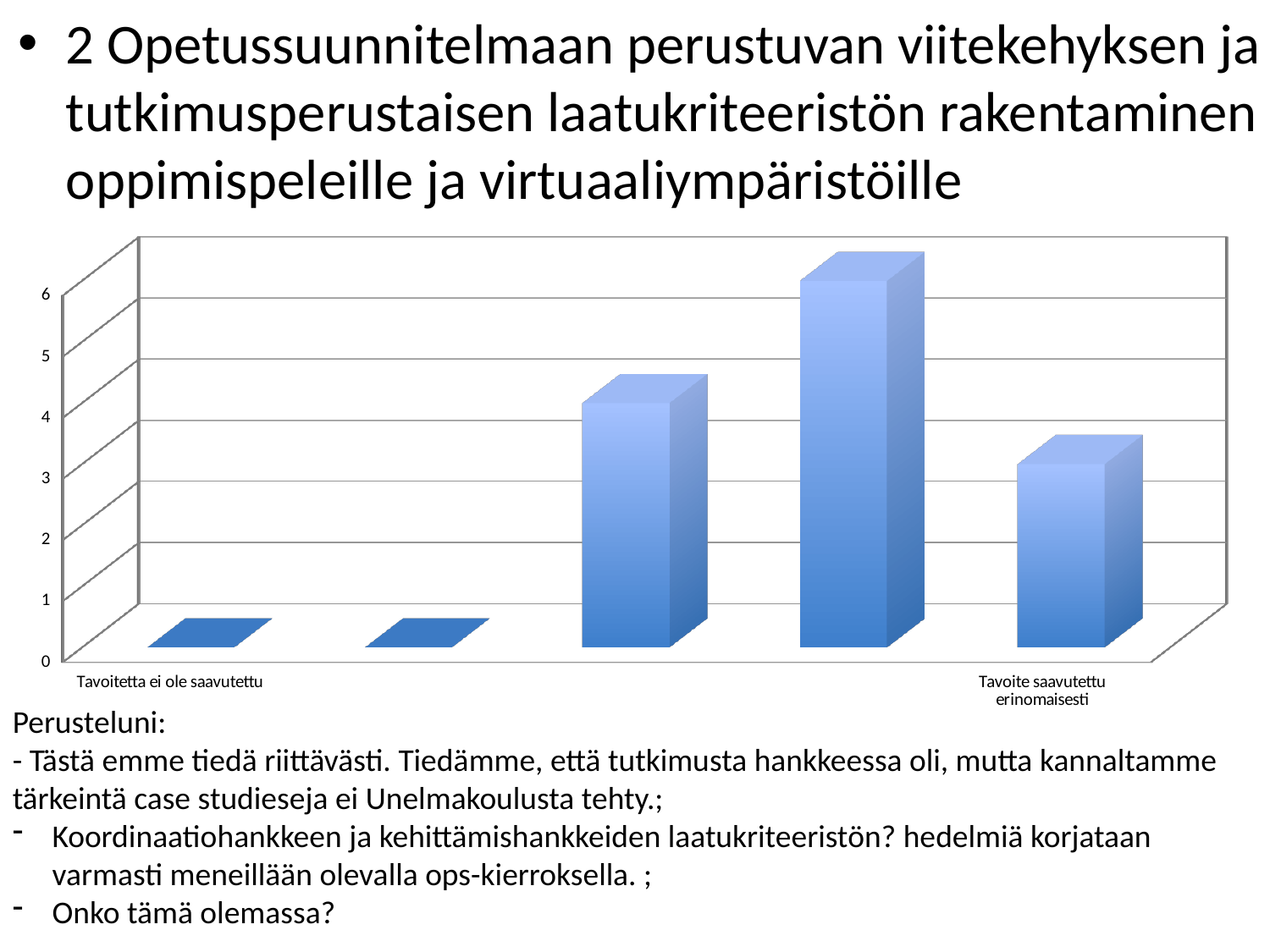
What colour are the bars in the chart? blue Is the value of the third bar from the left greater or less than 3? greater What kind of chart is shown on the slide? bar chart Is the value of the fourth bar from the left greater or less than 5? greater Do the values rise or fall from the fourth bar to the fifth bar? fall Is the value for "Tavoite saavutettu erinomaisesti" greater or less than 2? greater What is the value for "Tavoitetta ei ole saavutettu"? 0 Is the tallest bar the one labelled "Tavoite saavutettu erinomaisesti"? No How many bars (categories) does the chart show? 5 Which of the two labelled categories, "Tavoitetta ei ole saavutettu" or "Tavoite saavutettu erinomaisesti", has the larger value? Tavoite saavutettu erinomaisesti